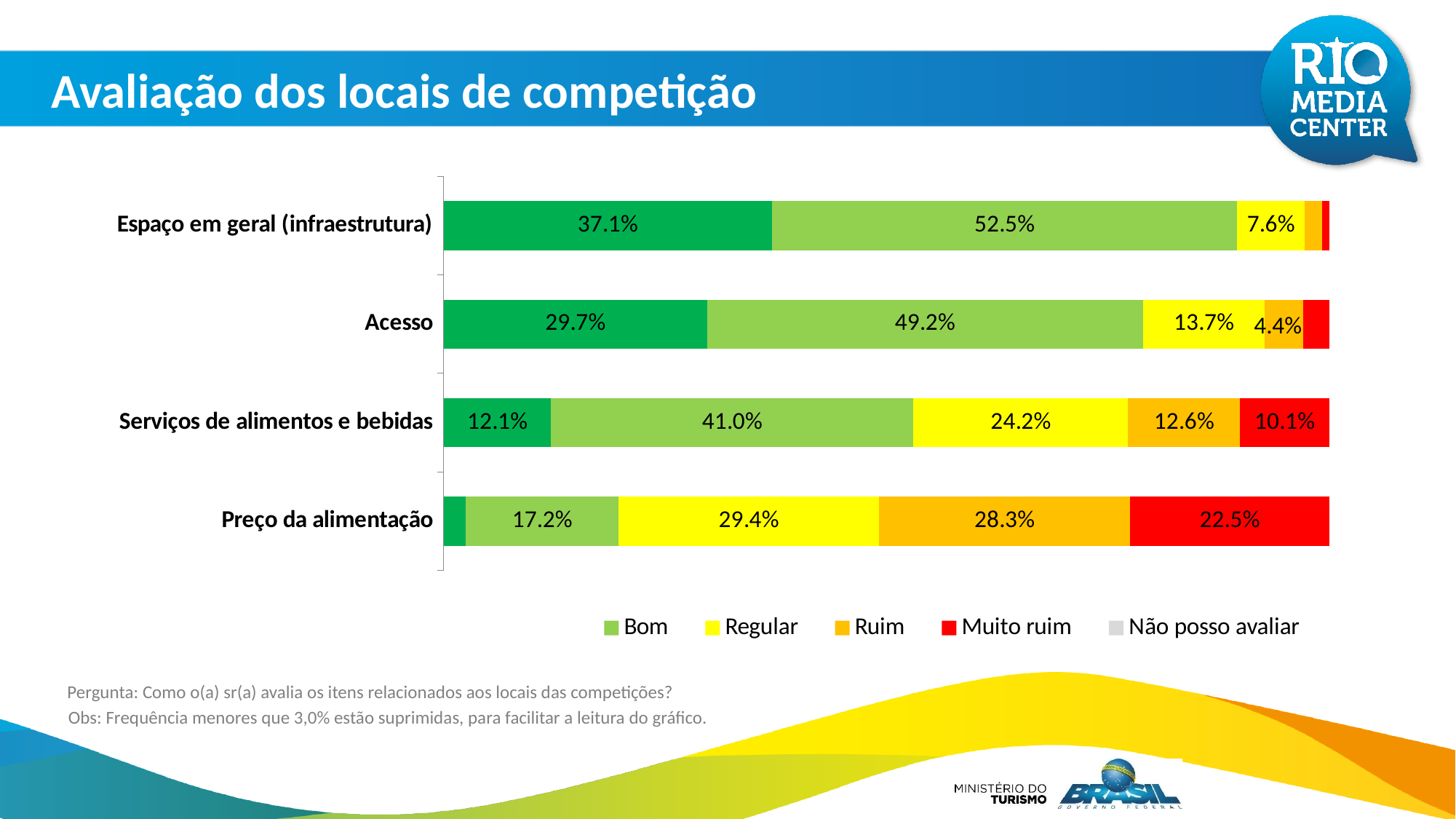
What is the Muito ruim value for Serviços de alimentos e bebidas? 10.1% What is the Regular value for Preço da alimentação? 29.4% What is the difference between the Regular value for Serviços de alimentos e bebidas and the Regular value for Acesso? 10.5 percentage points What is the Ruim value for Preço da alimentação? 28.3% What kind of chart is shown on the slide? Stacked bar chart Which category has the lowest Regular value? Espaço em geral (infraestrutura) How many categories are shown on the chart? 4 What is the value of the Bom segment for Acesso? 49.2% How many series does the legend list? 5 Which category has the highest Bom value? Espaço em geral (infraestrutura) Which is larger: the Ruim value for Preço da alimentação or the Ruim value for Serviços de alimentos e bebidas? Preço da alimentação Which category has the highest Muito ruim value? Preço da alimentação